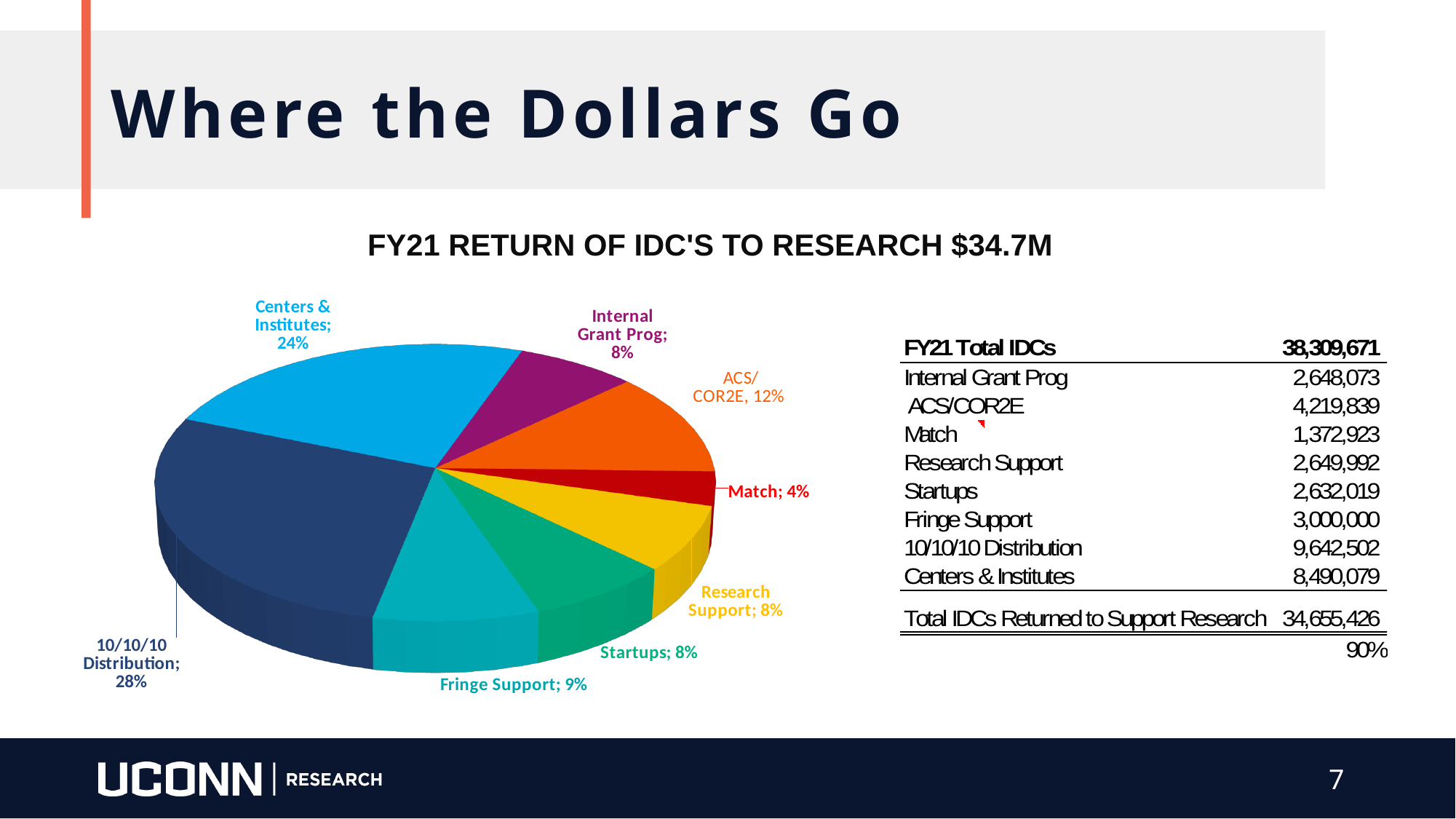
What is the title of the chart? FY21 RETURN OF IDC'S TO RESEARCH $34.7M What percentage is shown for ACS/COR2E in the pie chart? 12% What share of the pie does Centers & Institutes represent? 24% Which slice of the pie chart is the largest? 10/10/10 Distribution Which slice is larger, Fringe Support or Startups? Fringe Support Which slice of the pie chart is the smallest? Match What percentage does the Match slice show? 4% What share of the pie is labelled for Fringe Support? 9% Which slice is larger, ACS/COR2E or Internal Grant Prog? ACS/COR2E What type of chart is shown on the slide? Pie chart How many slices does the pie chart have? 8 How many percentage points larger is the 10/10/10 Distribution slice than the Centers & Institutes slice? 4 percentage points